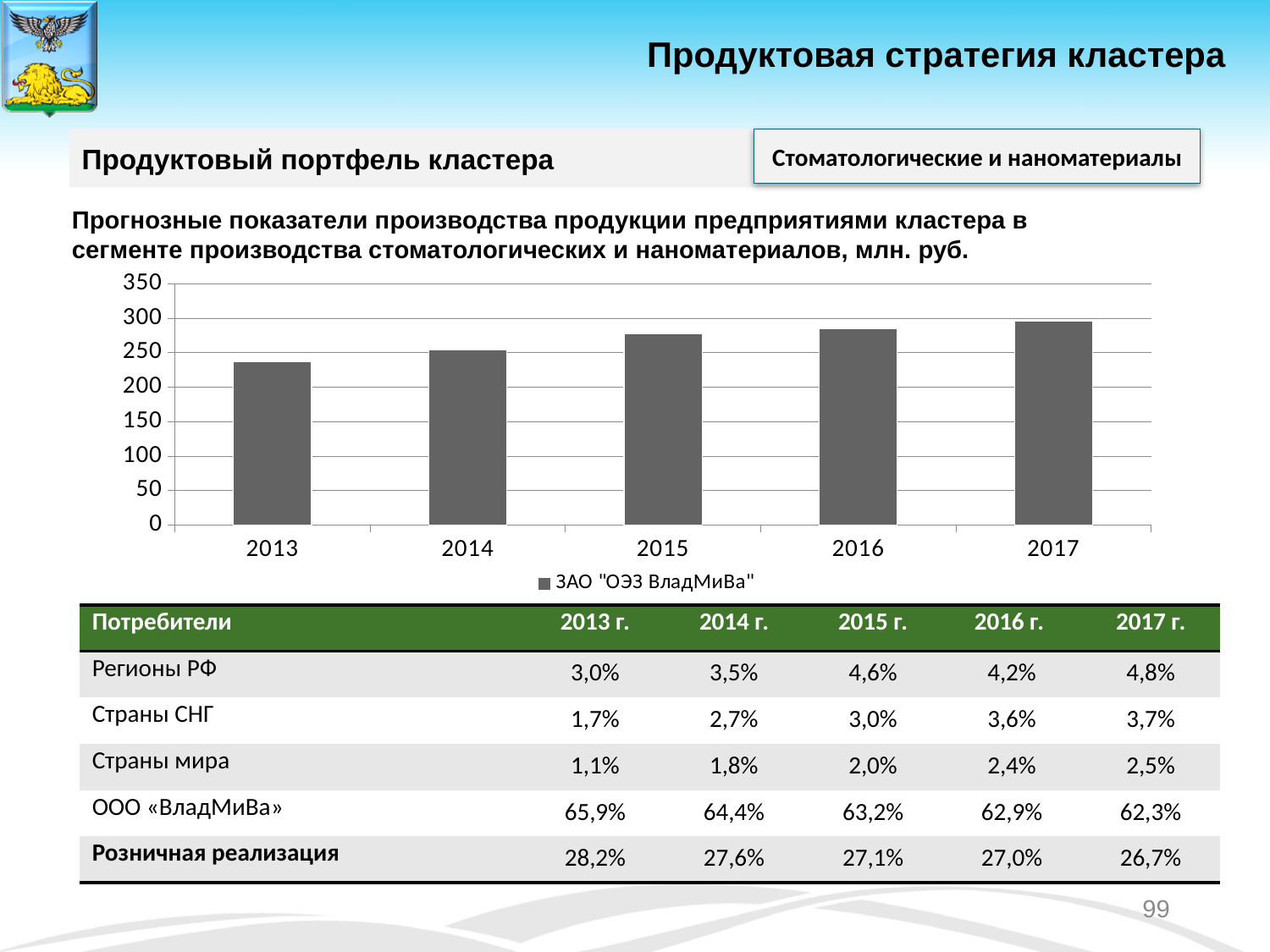
Is the value for 2013 greater or less than 250? less Which year has the lowest bar in the chart? 2013 Is the value for 2016 greater or less than 250? greater What series name is shown in the chart legend? ЗАО "ОЭЗ ВладМиВа" How many series does the chart legend list? 1 Do the values in the chart rise or fall from 2013 to 2017? rise Is the value for 2013 greater or less than 200? greater Which year has the highest bar in the chart? 2017 What kind of chart is shown on the slide? bar chart How many years (categories) are shown on the x axis of the chart? 5 Which is larger in the chart, the value for 2013 or the value for 2015? 2015